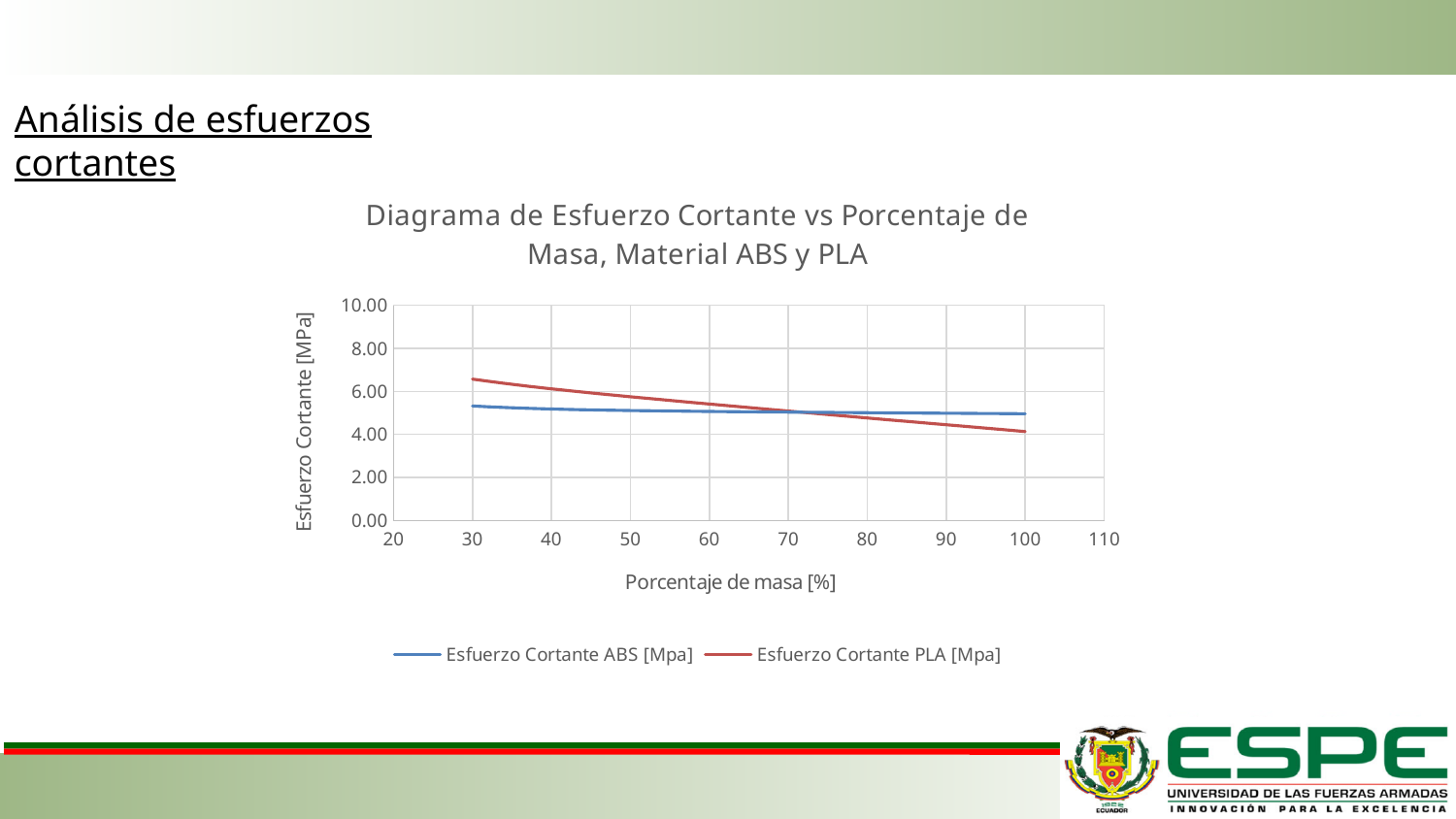
Is the value for Esfuerzo Cortante PLA [Mpa] at a mass percentage of 100 greater or less than 6.00? less At a mass percentage of 30, which series has the higher shear stress, ABS or PLA? Esfuerzo Cortante PLA [Mpa] What is the title of the chart? Diagrama de Esfuerzo Cortante vs Porcentaje de Masa, Material ABS y PLA Is the value for Esfuerzo Cortante PLA [Mpa] at a mass percentage of 30 greater or less than 6.00? greater At a mass percentage of 100, which series has the higher shear stress, ABS or PLA? Esfuerzo Cortante ABS [Mpa] Is the value for Esfuerzo Cortante ABS [Mpa] at a mass percentage of 100 greater or less than 6.00? less What kind of chart is shown on the slide? Line chart What is the label of the vertical axis? Esfuerzo Cortante [MPa] How many series does the legend list? 2 Does the Esfuerzo Cortante ABS [Mpa] series rise or fall as the percentage of mass increases? Fall Does the Esfuerzo Cortante PLA [Mpa] series rise or fall as the percentage of mass increases? Fall